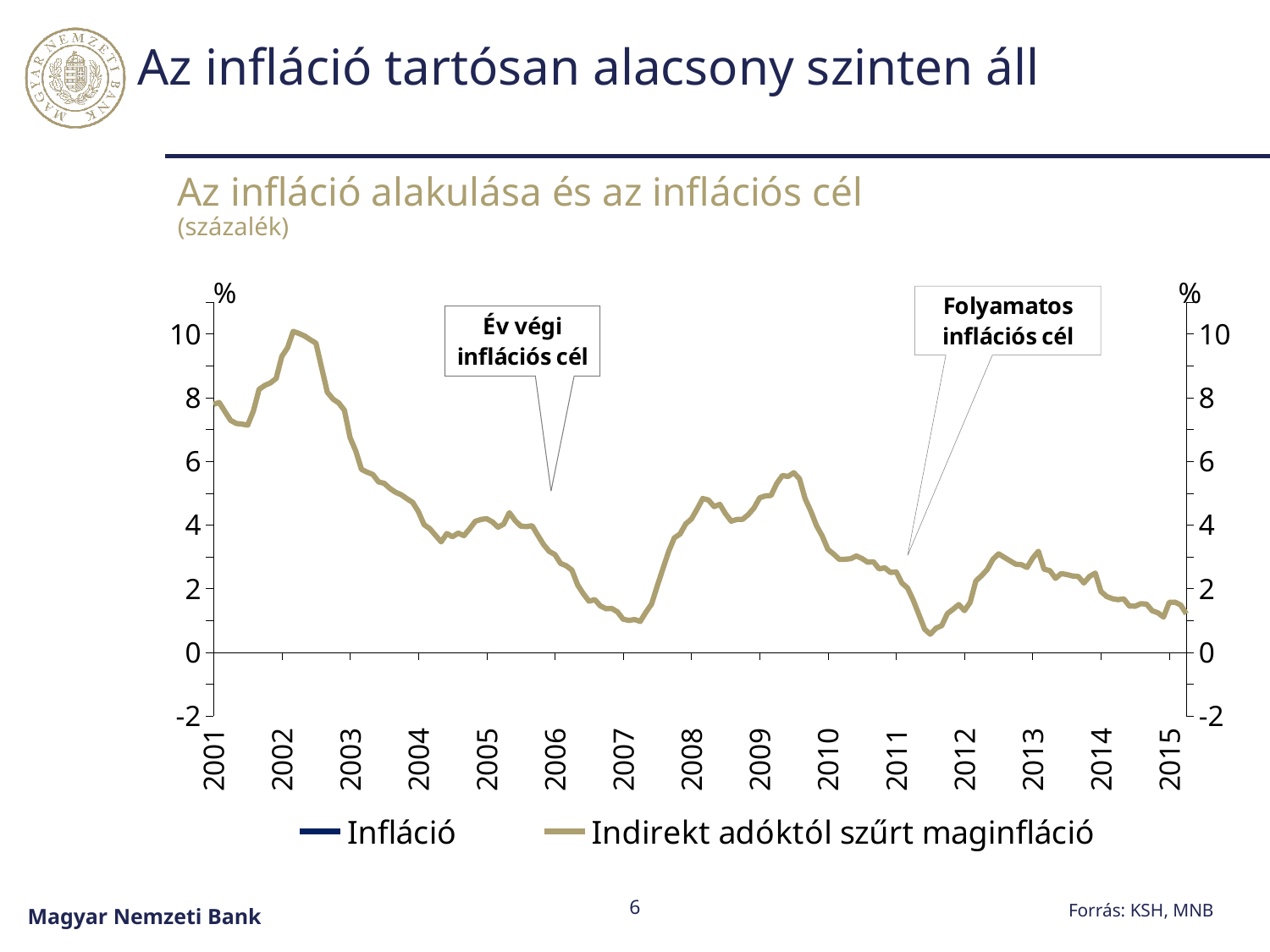
Is the value of the plotted line at the start of 2001 greater or less than 6? greater How many series does the legend list? 2 What is the title of the chart? Az infláció alakulása és az inflációs cél How many year labels are shown on the x axis? 15 Is the value of the plotted line at the start of 2009 greater or less than 4? greater In which year does the plotted line reach its lowest point? 2011 Is the value of the plotted line at the start of 2007 greater or less than 2? less Does the plotted line rise or fall between 2002 and 2007? fall What unit is shown on the vertical axes of the chart? % What kind of chart is shown on the slide? line chart In which year does the plotted line reach its highest point? 2002